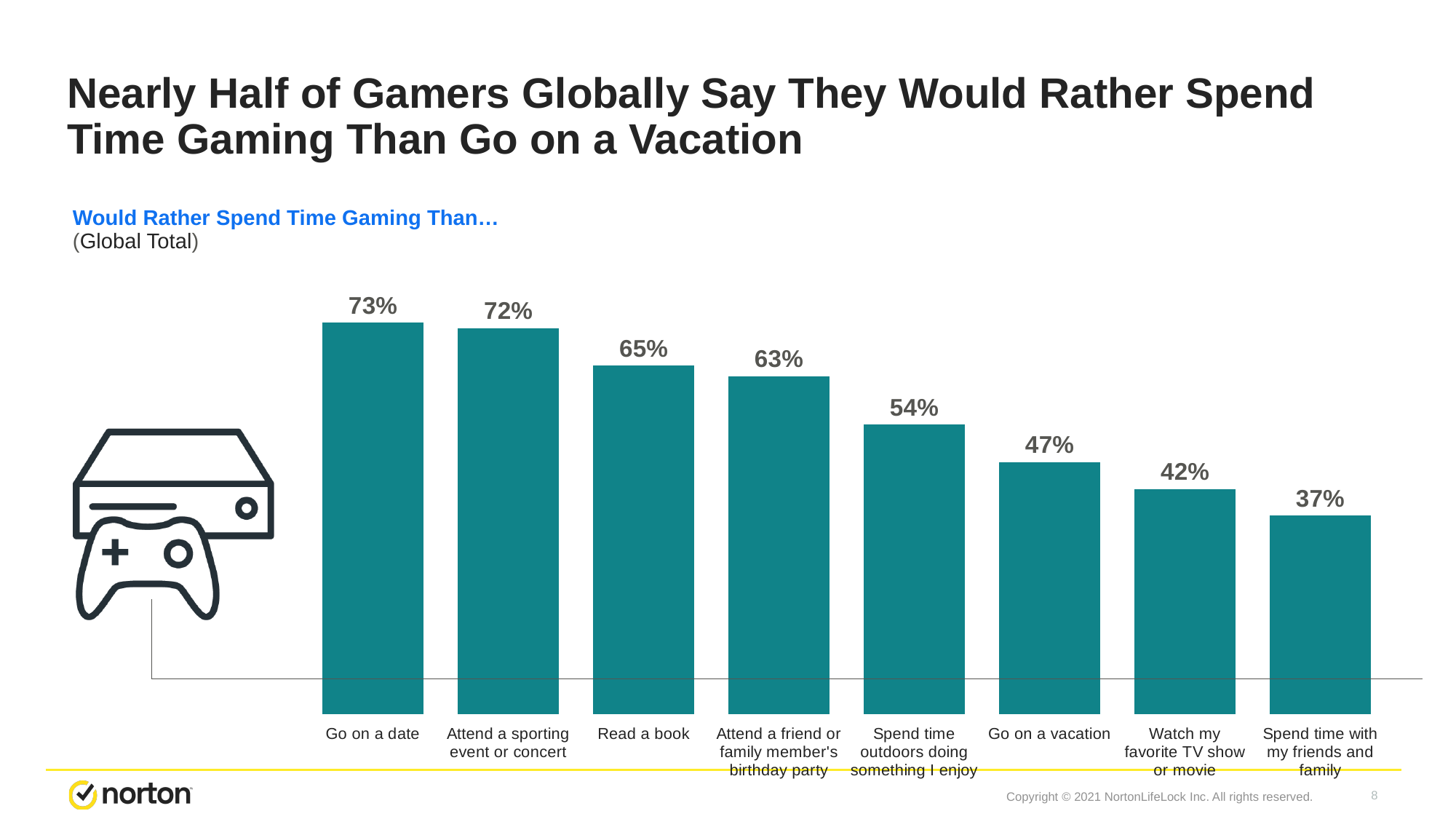
How many activities are shown in the chart? 8 Which activity has the lowest percentage of gamers who would rather spend time gaming? Spend time with my friends and family What kind of chart is shown on the slide? Bar chart What is the value for 'Spend time with my friends and family'? 37% What percentage of gamers would rather spend time gaming than go on a date? 73% What is the difference between the values for 'Go on a date' and 'Go on a vacation'? 26 percentage points What percentage of gamers would rather spend time gaming than go on a vacation? 47% Do the values rise or fall from left to right across the chart? Fall What is the title of the chart? Would Rather Spend Time Gaming Than… (Global Total) Which activity has the highest percentage of gamers who would rather spend time gaming? Go on a date Which is larger: the value for 'Read a book' or the value for 'Watch my favorite TV show or movie'? Read a book What is the value for 'Read a book'? 65%